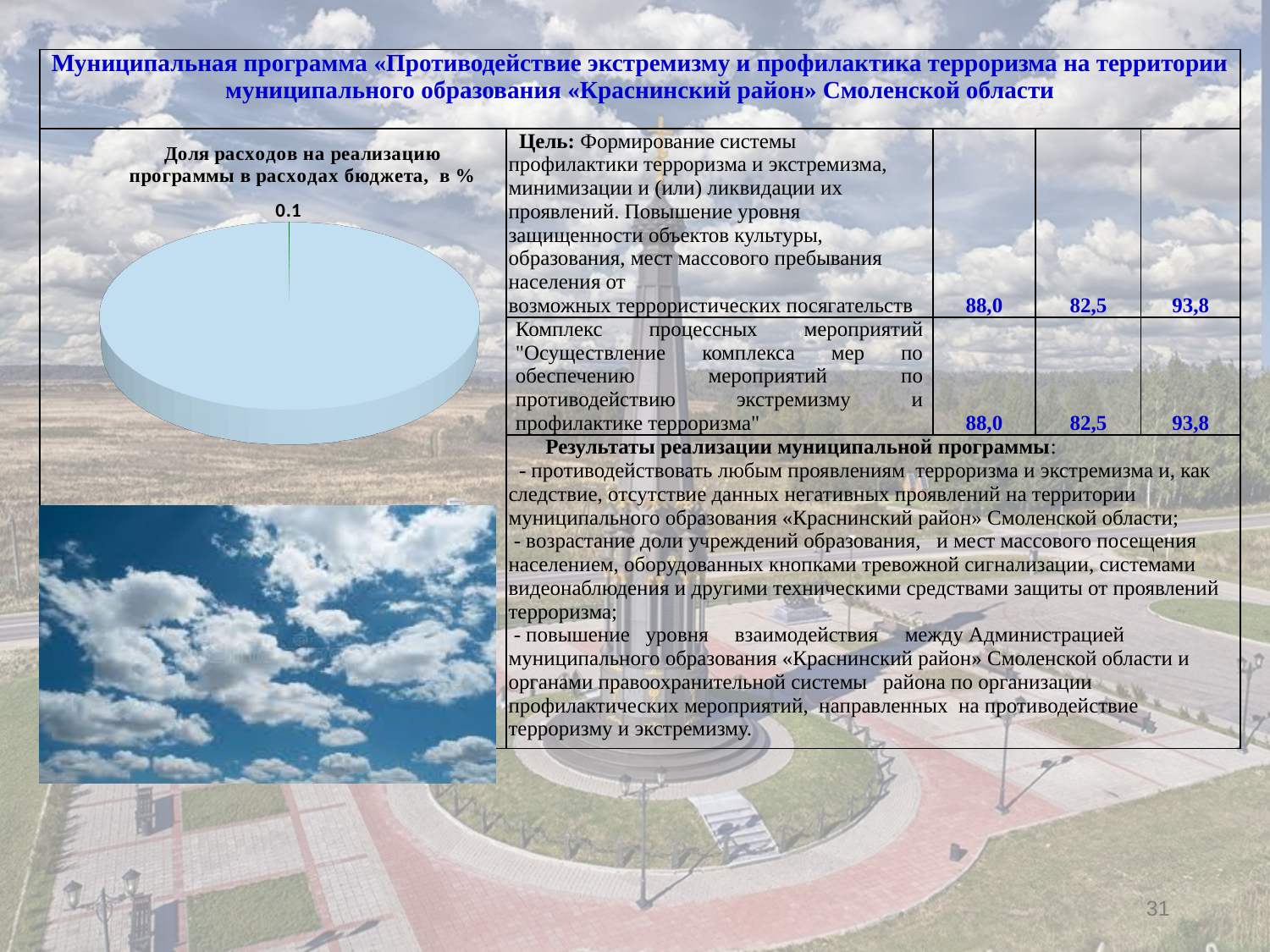
Is the value labelled on the pie chart greater or less than 1? less According to the pie chart title, in what unit is the share of programme expenditure expressed? % What is the title of the pie chart? Доля расходов на реализацию программы в расходах бюджета, в % What kind of chart is shown on the left of the slide? pie chart What value is printed as the data label on the pie chart? 0.1